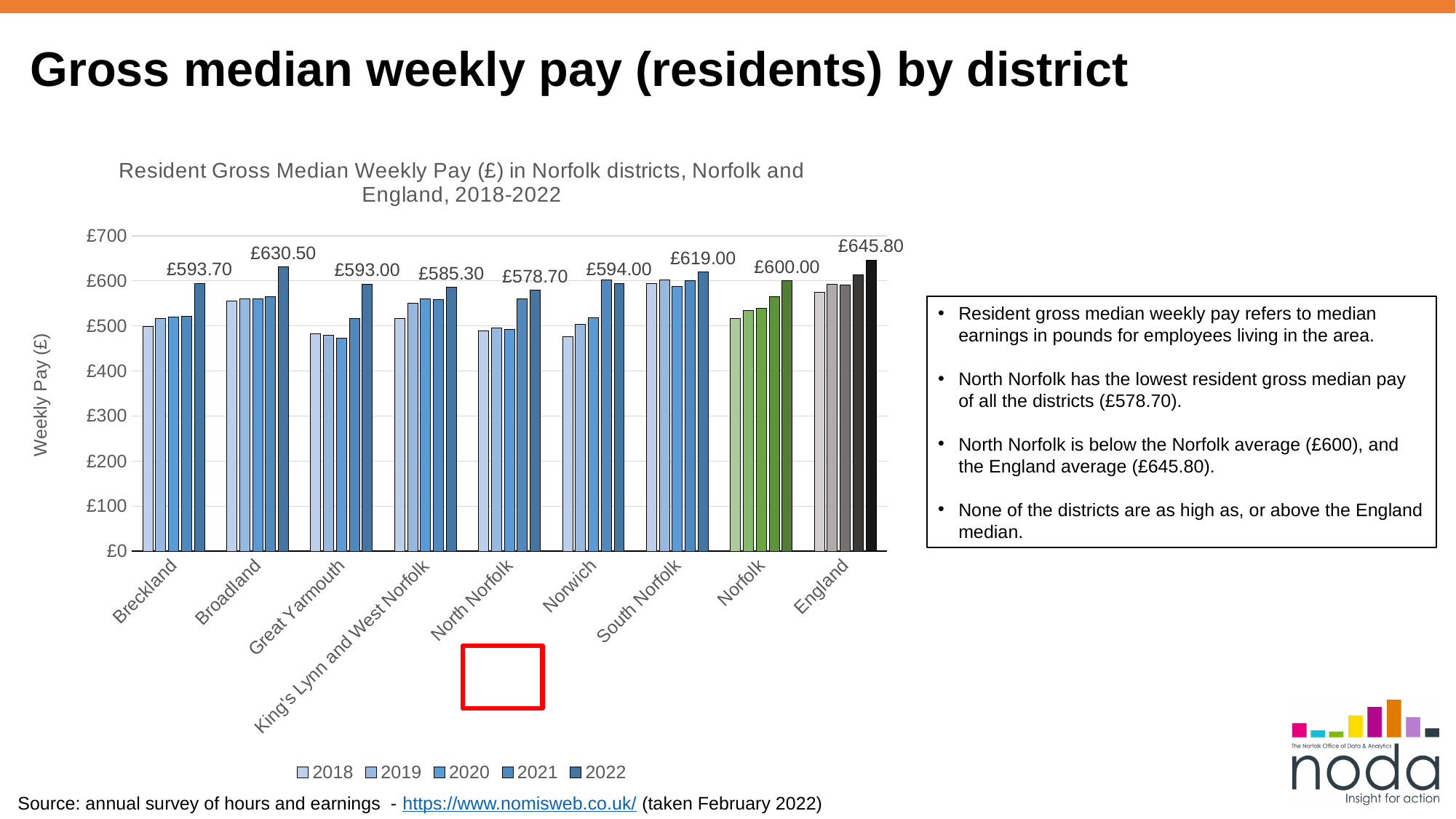
What is the 2022 value for South Norfolk? £619.00 What is the 2022 value for Broadland? £630.50 Which category has the lowest 2022 value? North Norfolk How many categories are shown on the x axis? 9 What kind of chart is shown on the slide? bar chart What is the 2022 value for North Norfolk? £578.70 Which category has the highest 2022 value? England Is the 2018 value for Norwich greater or less than £500? less How many series does the legend list? 5 What is the difference between the 2022 values for England and Norfolk? £45.80 Which has the larger 2022 value, Broadland or South Norfolk? Broadland What is the 2022 value for England? £645.80